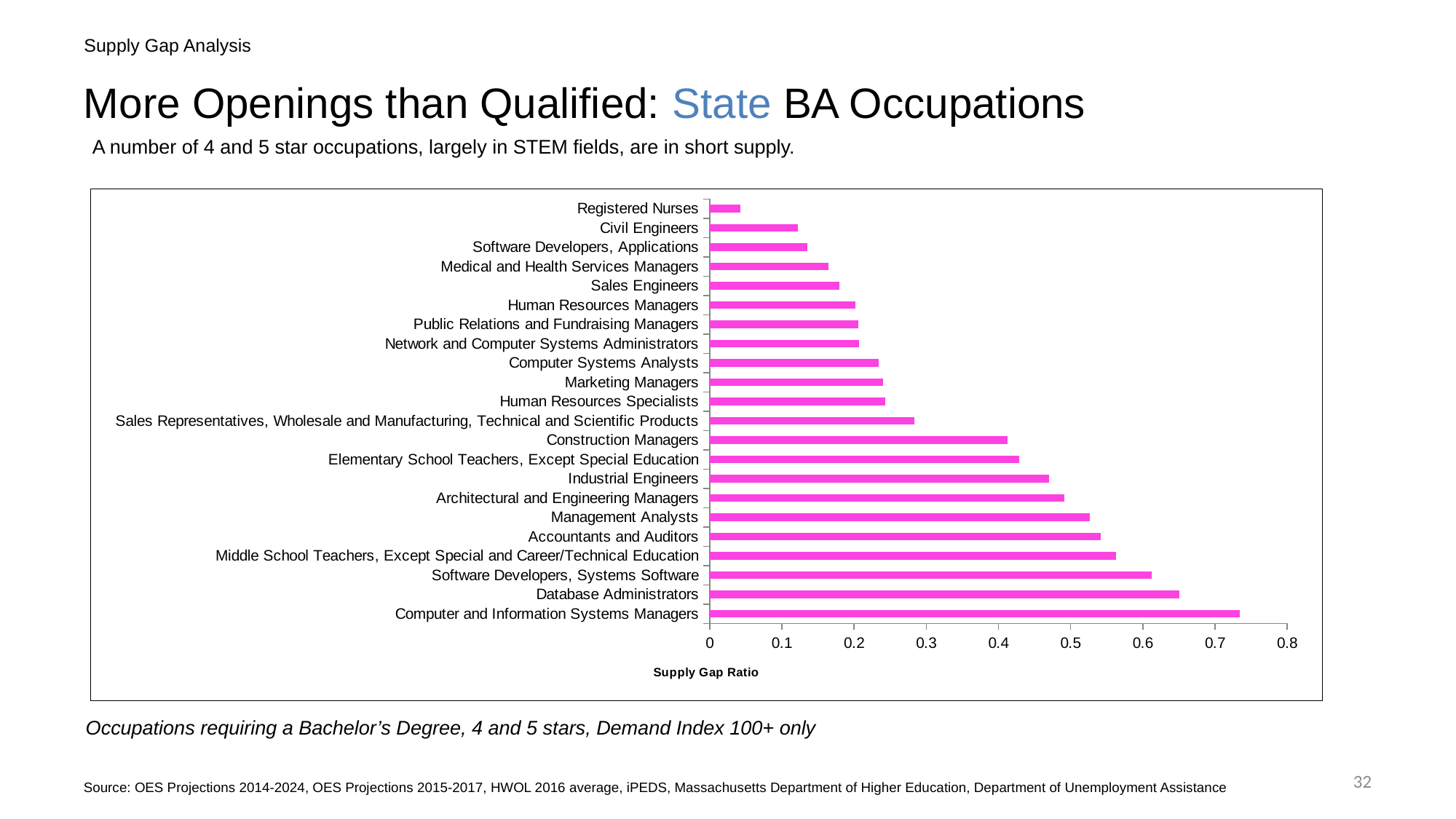
Is the Supply Gap Ratio for Database Administrators greater or less than 0.6? greater Which has a larger Supply Gap Ratio, Database Administrators or Software Developers, Systems Software? Database Administrators Is the Supply Gap Ratio for Sales Representatives, Wholesale and Manufacturing, Technical and Scientific Products greater or less than 0.3? less Is the Supply Gap Ratio for Registered Nurses greater or less than 0.1? less How many occupations are plotted in the chart? 22 Which occupation has the highest Supply Gap Ratio? Computer and Information Systems Managers What is the label of the horizontal axis of the chart? Supply Gap Ratio Which occupation has the lowest Supply Gap Ratio? Registered Nurses Which has a larger Supply Gap Ratio, Construction Managers or Human Resources Specialists? Construction Managers What kind of chart is shown on the slide? bar chart